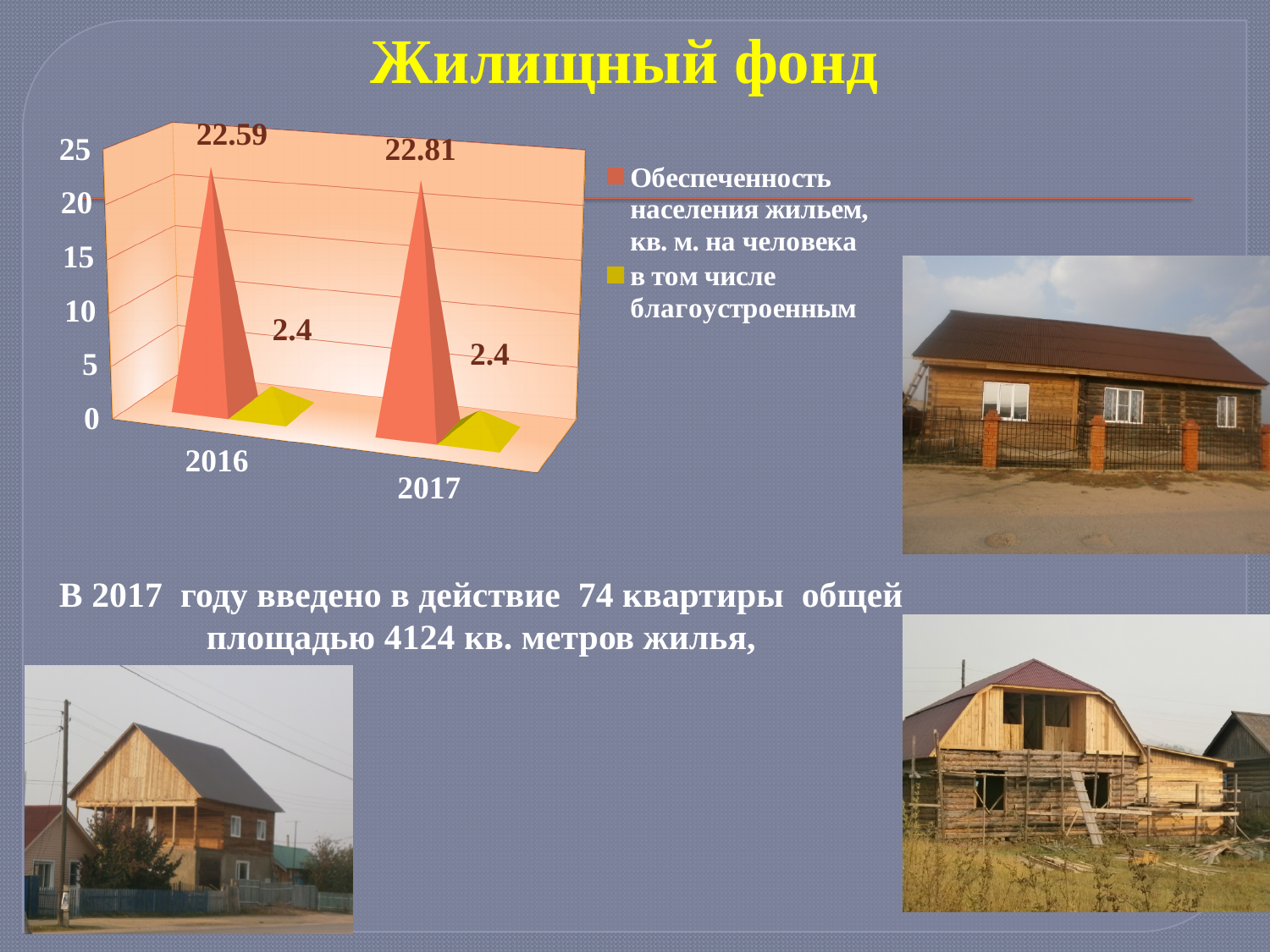
What is the value of 'Обеспеченность населения жильем, кв. м. на человека' for 2017? 22.81 What is the value of 'в том числе благоустроенным' for 2016? 2.4 What is the value of 'в том числе благоустроенным' for 2017? 2.4 Is the value of 'Обеспеченность населения жильем' for 2016 greater or less than 20? greater What is the difference between the two series values for 2017? 20.41 What is the difference between the 'Обеспеченность населения жильем' values for 2017 and 2016? 0.22 How many years (categories) are shown on the x axis of the chart? 2 What is the value of 'Обеспеченность населения жильем, кв. м. на человека' for 2016? 22.59 Does the value of 'Обеспеченность населения жильем' rise or fall from 2016 to 2017? rise Is the value of 'в том числе благоустроенным' for 2017 greater or less than 5? less How many series does the chart legend list? 2 In which year is 'Обеспеченность населения жильем, кв. м. на человека' higher? 2017